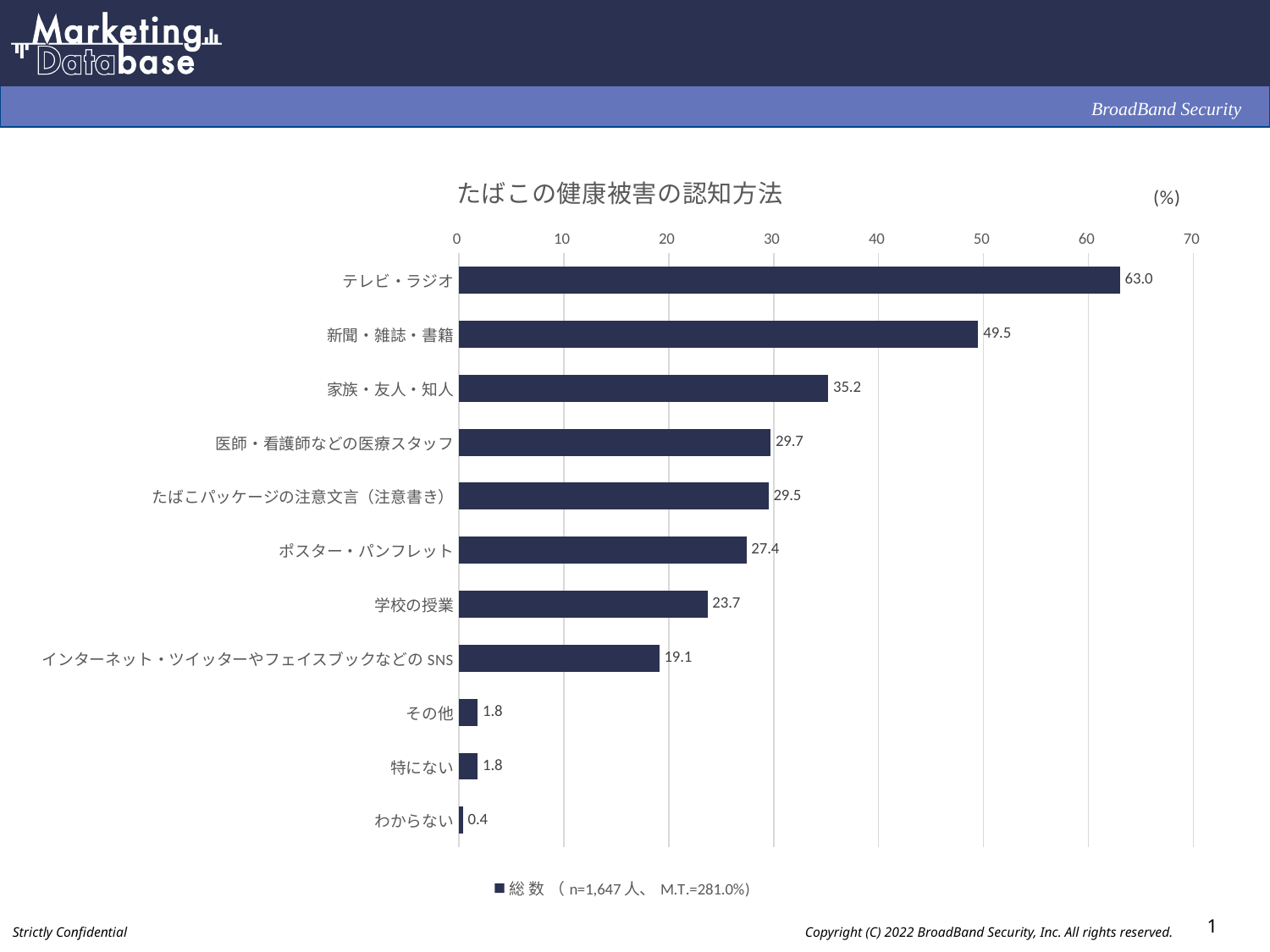
What is the value for 学校の授業? 23.7 Which category has the highest value? テレビ・ラジオ What is the value for テレビ・ラジオ? 63.0 Which is larger, the value for 家族・友人・知人 or the value for ポスター・パンフレット? 家族・友人・知人 How many categories are shown in the chart? 11 Is the value for 新聞・雑誌・書籍 greater or less than 40? greater What is the title of the chart? たばこの健康被害の認知方法 What is the difference between the values for テレビ・ラジオ and 新聞・雑誌・書籍? 13.5 What is the value for インターネット・ツイッターやフェイスブックなどのSNS? 19.1 Which category has the lowest value? わからない What kind of chart is shown on the slide? bar chart How many series does the legend list? 1